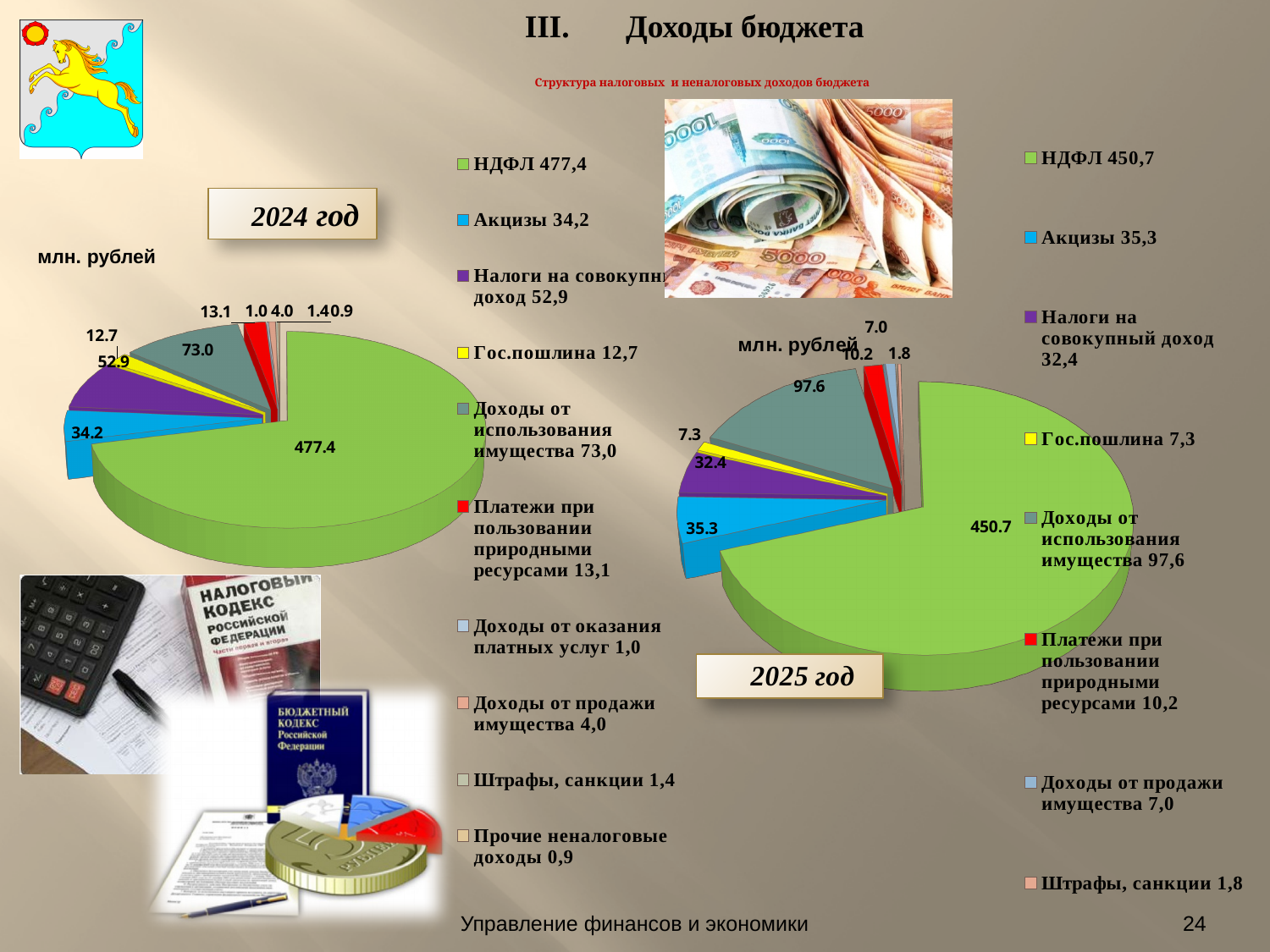
On the 2024 год pie chart, which category has the largest value? НДФЛ How many categories are shown on the 2024 год pie chart? 10 Which is larger: Налоги на совокупный доход on the 2024 год chart or on the 2025 год chart? 2024 год On the 2024 год pie chart, what is the value for НДФЛ? 477.4 On the 2025 год pie chart, which category has the smallest value? Штрафы, санкции On the 2025 год pie chart, what is the difference between Доходы от использования имущества and Налоги на совокупный доход? 65.2 How many categories are shown on the 2025 год pie chart? 8 What type of chart is used for the 2025 год data? Pie chart What is the difference between the НДФЛ value on the 2024 год chart and the НДФЛ value on the 2025 год chart? 26.7 On the 2025 год pie chart, what is the value for Доходы от использования имущества? 97.6 On the 2025 год pie chart, what is the value for Акцизы? 35.3 On the 2024 год pie chart, which category has the smallest value? Прочие неналоговые доходы